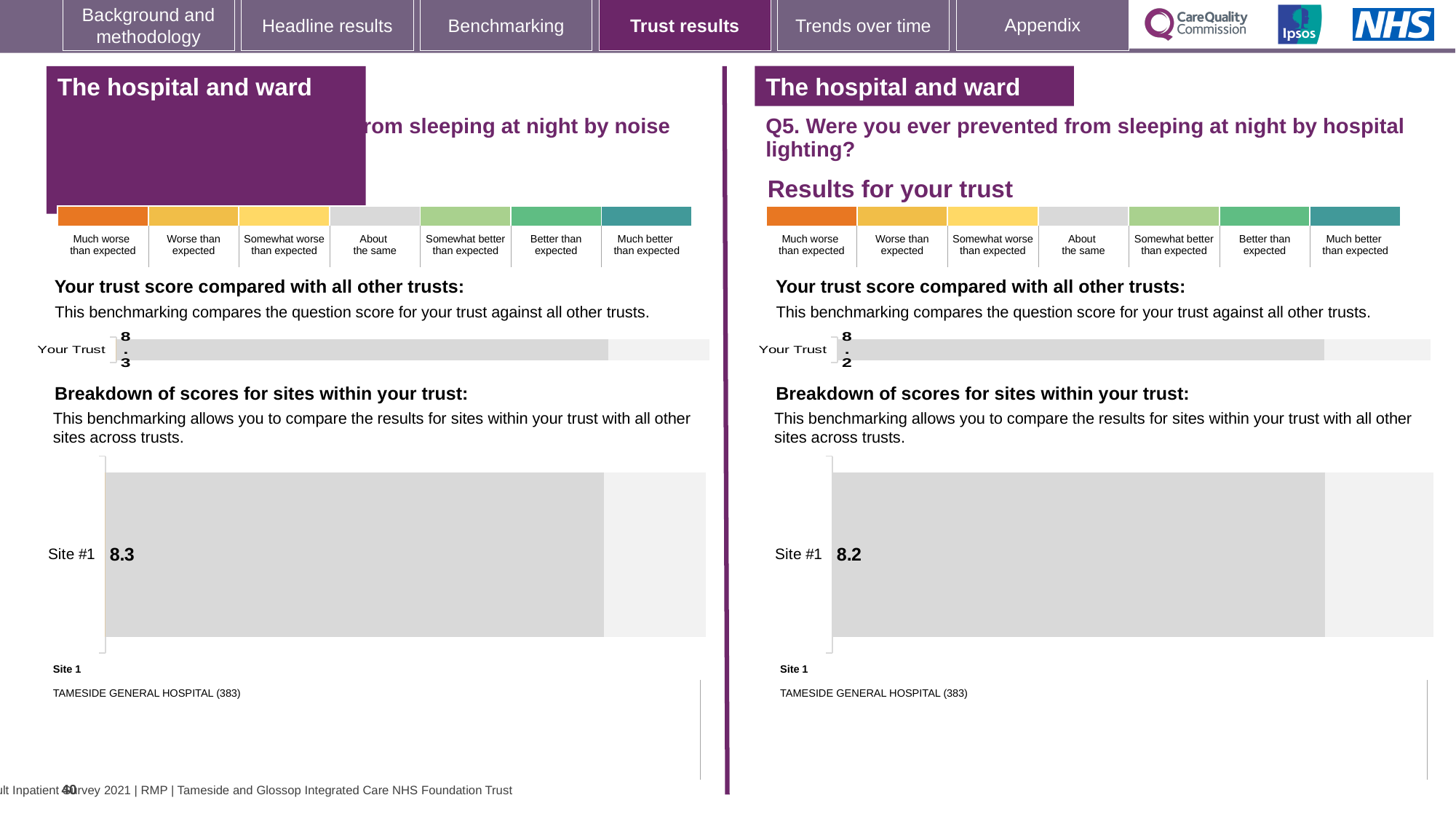
What is the difference between the Your Trust score on the left-hand side (8.3) and the Your Trust score on the right-hand side (8.2)? 0.1 How many benchmark categories are shown in the colour key above the right-hand 'Your trust score compared with all other trusts' chart? 7 How many sites are shown in the right-hand 'Breakdown of scores for sites within your trust' chart (Q5, hospital lighting)? 1 Which is larger: the Site #1 score in the left-hand chart (noise) or the Site #1 score in the right-hand chart (Q5, hospital lighting)? Left-hand chart (noise), 8.3 On the left-hand side of the slide (sleeping at night by noise), what is the score shown for Your Trust? 8.3 What type of chart is used to show the Site #1 score in the right-hand 'Breakdown of scores for sites within your trust' section? Bar chart Is the Site #1 score in the right-hand chart (Q5, hospital lighting) greater or less than 8.3? less On the right-hand side of the slide (Q5, hospital lighting), what is the score shown for Your Trust? 8.2 How many sites are shown in the left-hand 'Breakdown of scores for sites within your trust' chart (noise question)? 1 In the left-hand 'Breakdown of scores for sites within your trust' chart (noise question), what is the score for Site #1? 8.3 In the right-hand 'Breakdown of scores for sites within your trust' chart (Q5, hospital lighting), what is the score for Site #1? 8.2 Which site name is listed as Site 1 below the right-hand breakdown chart (Q5, hospital lighting)? TAMESIDE GENERAL HOSPITAL (383)